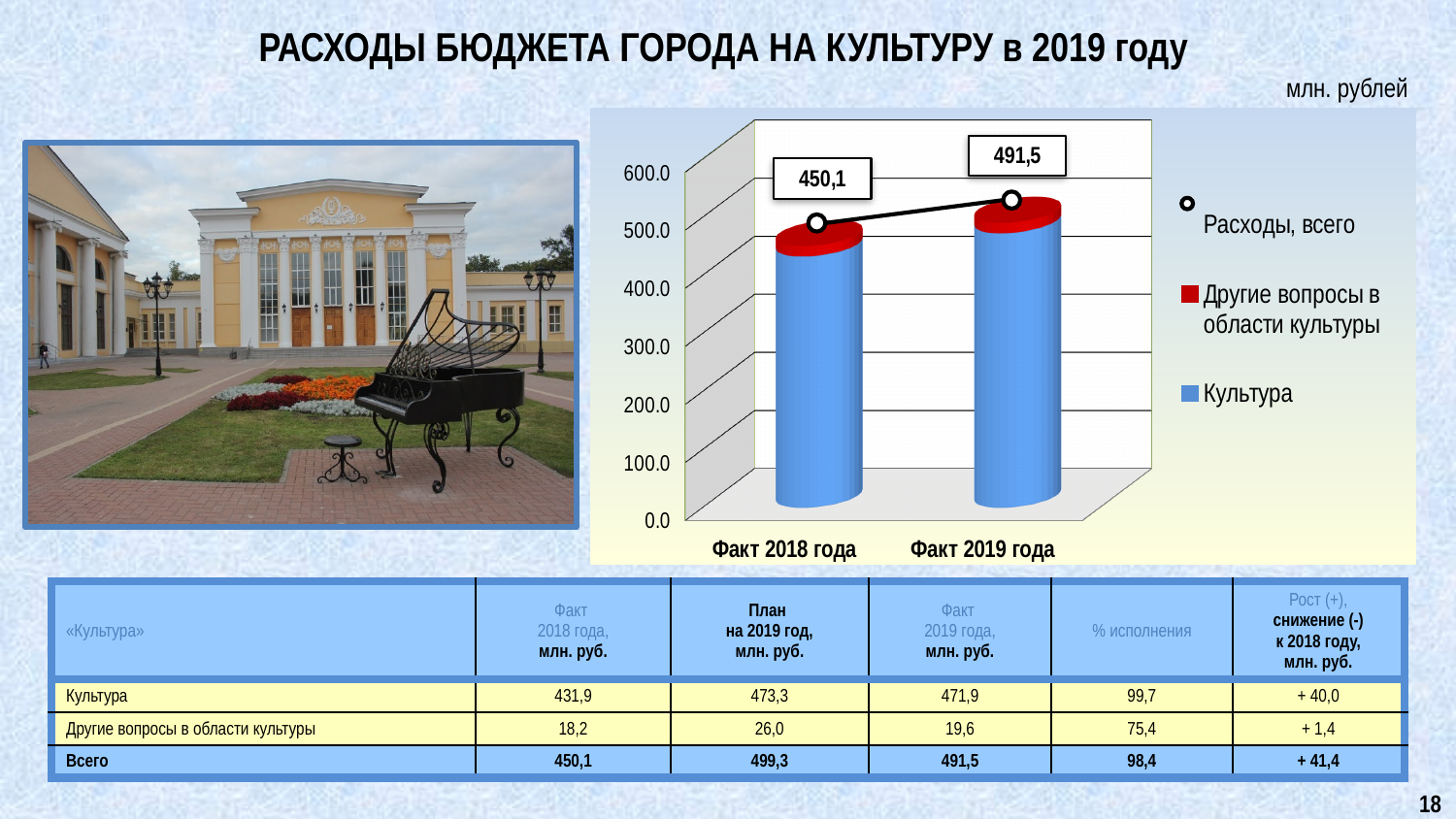
Is the value of "Культура" for "Факт 2019 года" greater or less than 400.0? greater What is the value of "Расходы, всего" for "Факт 2019 года"? 491,5 Does "Расходы, всего" rise or fall from "Факт 2018 года" to "Факт 2019 года"? rise What is the value of "Расходы, всего" for "Факт 2018 года"? 450,1 How many series does the chart legend list? 3 How many categories are shown on the x axis of the chart? 2 Is the value of "Культура" for "Факт 2018 года" greater or less than 500.0? less What is the difference between the "Расходы, всего" values for "Факт 2019 года" and "Факт 2018 года"? 41,4 Which category has the lower value for "Расходы, всего"? Факт 2018 года Which category has the higher value for "Расходы, всего"? Факт 2019 года What type of chart is shown on the slide? bar chart Which colour represents "Другие вопросы в области культуры" in the chart? red